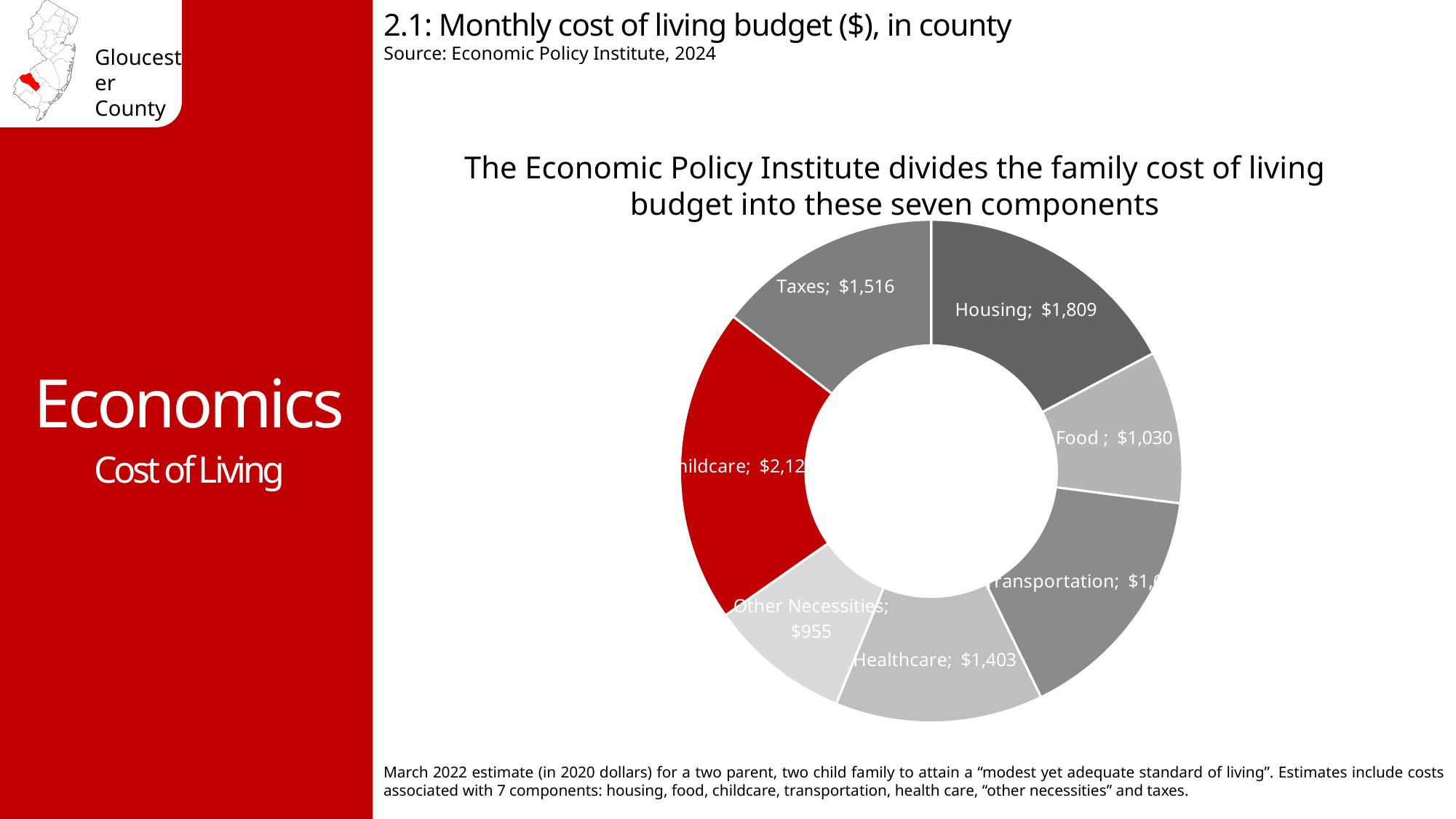
How many components are shown in the chart? 7 Which is larger, the monthly cost for Housing or for Taxes? Housing Which component has the largest monthly cost? Childcare What is the monthly cost for Housing? $1,809 What is the difference between the Healthcare and Food monthly costs? $373 What is the monthly cost for Food? $1,030 Which component has the smallest monthly cost? Other Necessities What kind of chart is shown on the slide? Doughnut chart What is the difference between the Housing and Taxes monthly costs? $293 What is the monthly cost for Healthcare? $1,403 What is the monthly cost for Taxes? $1,516 What is the monthly cost for Other Necessities? $955